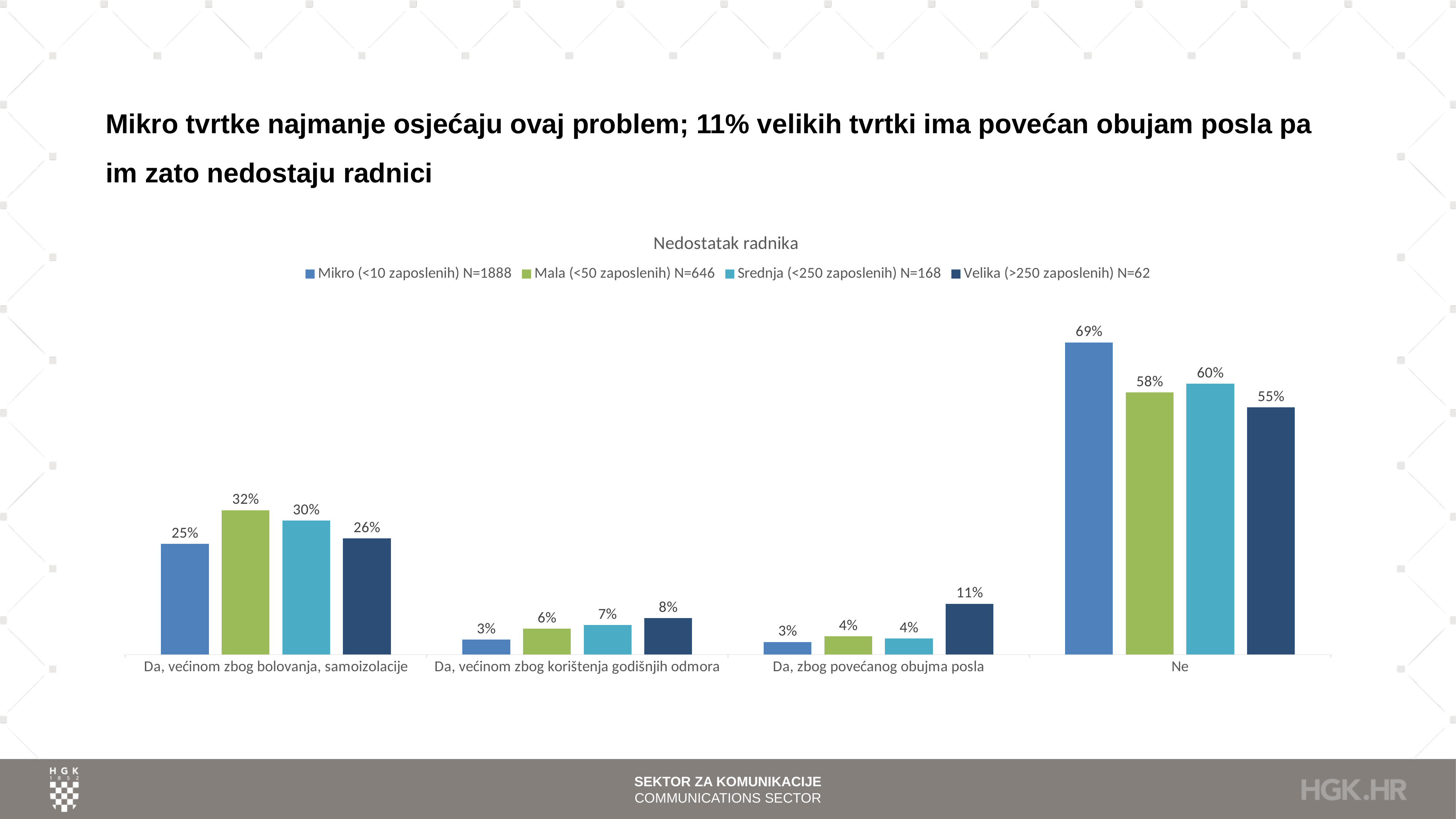
Which is larger in the 'Da, većinom zbog bolovanja, samoizolacije' category: the Srednja value or the Velika value? Srednja (<250 zaposlenih) N=168 What is the value for Mikro (<10 zaposlenih) in the 'Ne' category? 69% How many categories are shown on the x axis? 4 What is the sample size (N) for the Velika (>250 zaposlenih) series in the legend? N=62 What is the title of the chart? Nedostatak radnika What kind of chart is shown on the slide? Bar chart Which series has the lowest value in the 'Da, većinom zbog korištenja godišnjih odmora' category? Mikro (<10 zaposlenih) N=1888 Which series has the highest value in the 'Ne' category? Mikro (<10 zaposlenih) N=1888 What is the value for Velika (>250 zaposlenih) in the 'Da, zbog povećanog obujma posla' category? 11% How many series does the legend list? 4 What is the difference between the Mikro and Velika values in the 'Ne' category? 14% What is the value for Mala (<50 zaposlenih) in the 'Da, većinom zbog bolovanja, samoizolacije' category? 32%